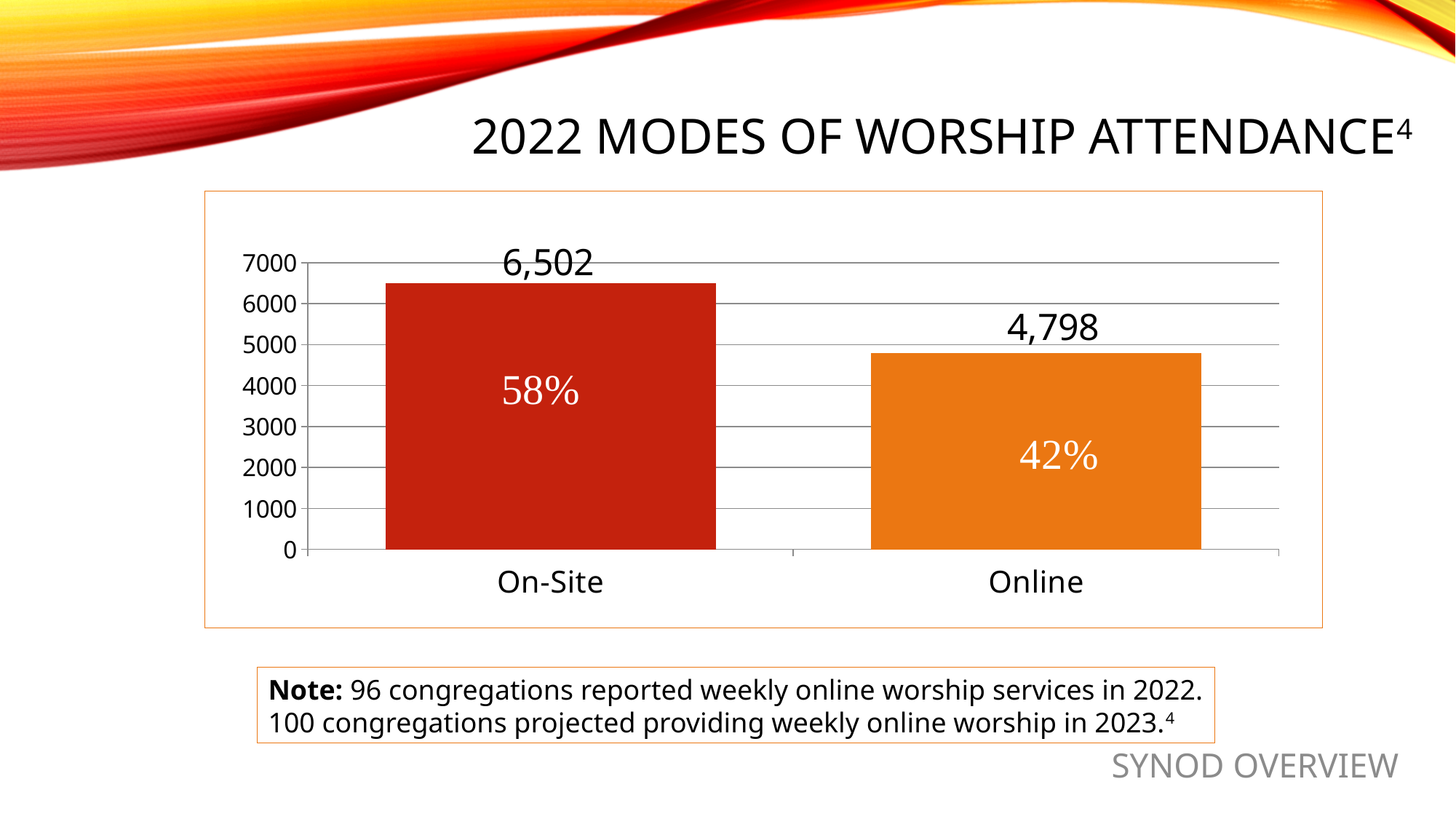
What kind of chart is shown on the slide? Bar chart What is the title of the slide containing the chart? 2022 Modes of Worship Attendance What percentage is shown inside the On-Site bar? 58% Which mode of worship attendance has the lowest value? Online What is the attendance value for On-Site? 6,502 Which mode of worship attendance has the highest value? On-Site What percentage is shown inside the Online bar? 42% Is the value for Online greater or less than 5000? less What is the difference between the On-Site and Online attendance values? 1,704 What is the attendance value for Online? 4,798 Which is larger, the On-Site value or the Online value? On-Site How many categories are shown on the chart? 2